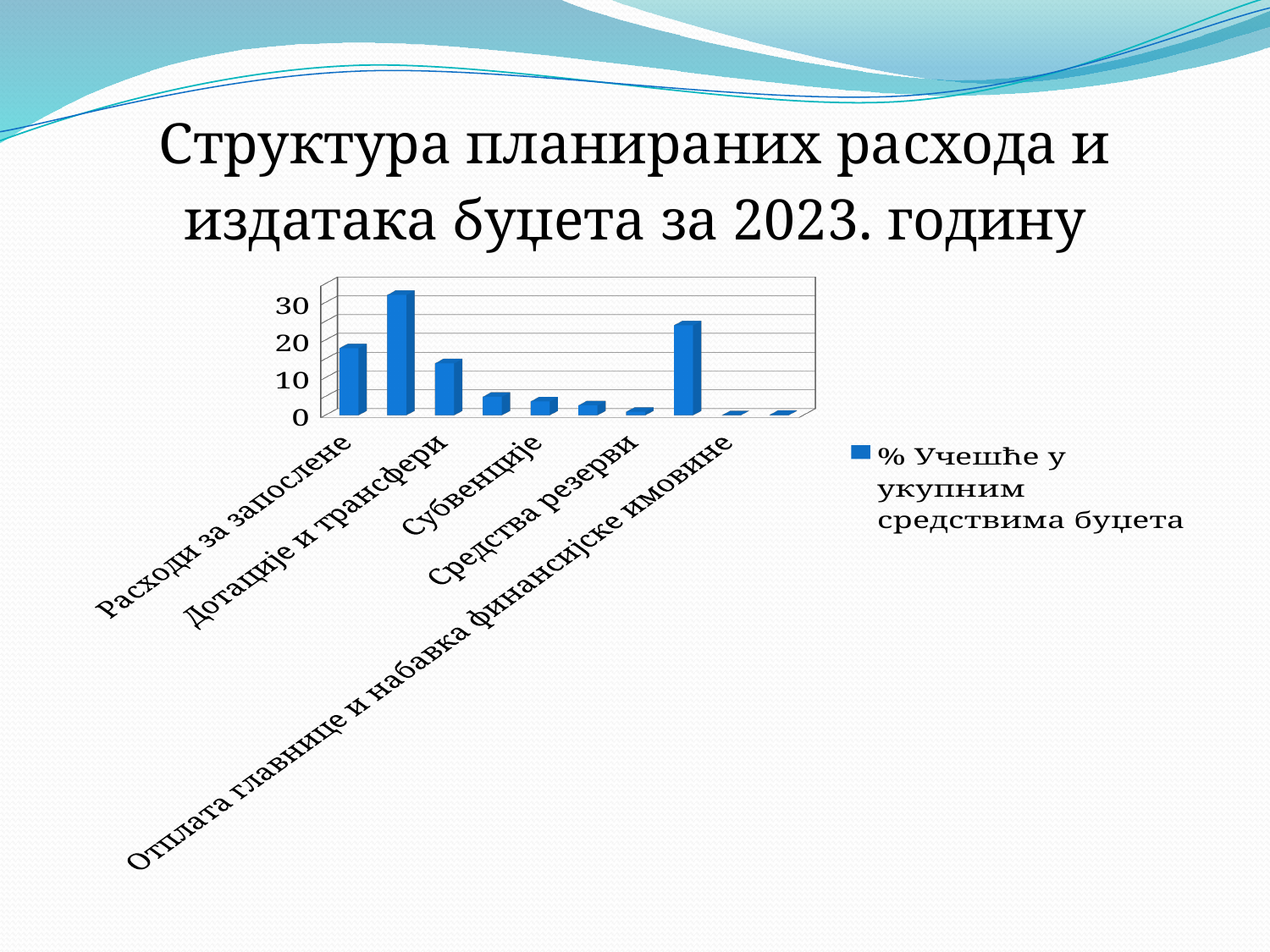
Is the value for Дотације и трансфери greater or less than 20? less Which is larger, the value for Расходи за запослене or the value for Субвенције? Расходи за запослене Is the value for Расходи за запослене greater or less than 20? less Which is larger, the value for Дотације и трансфери or the value for Средства резерви? Дотације и трансфери How many series does the legend list? 1 What kind of chart is shown on the slide? bar chart What is the legend entry for the series in the chart? % Учешће у укупним средствима буџета How many bars are plotted in the chart? 10 Is the value for Субвенције greater or less than 10? less